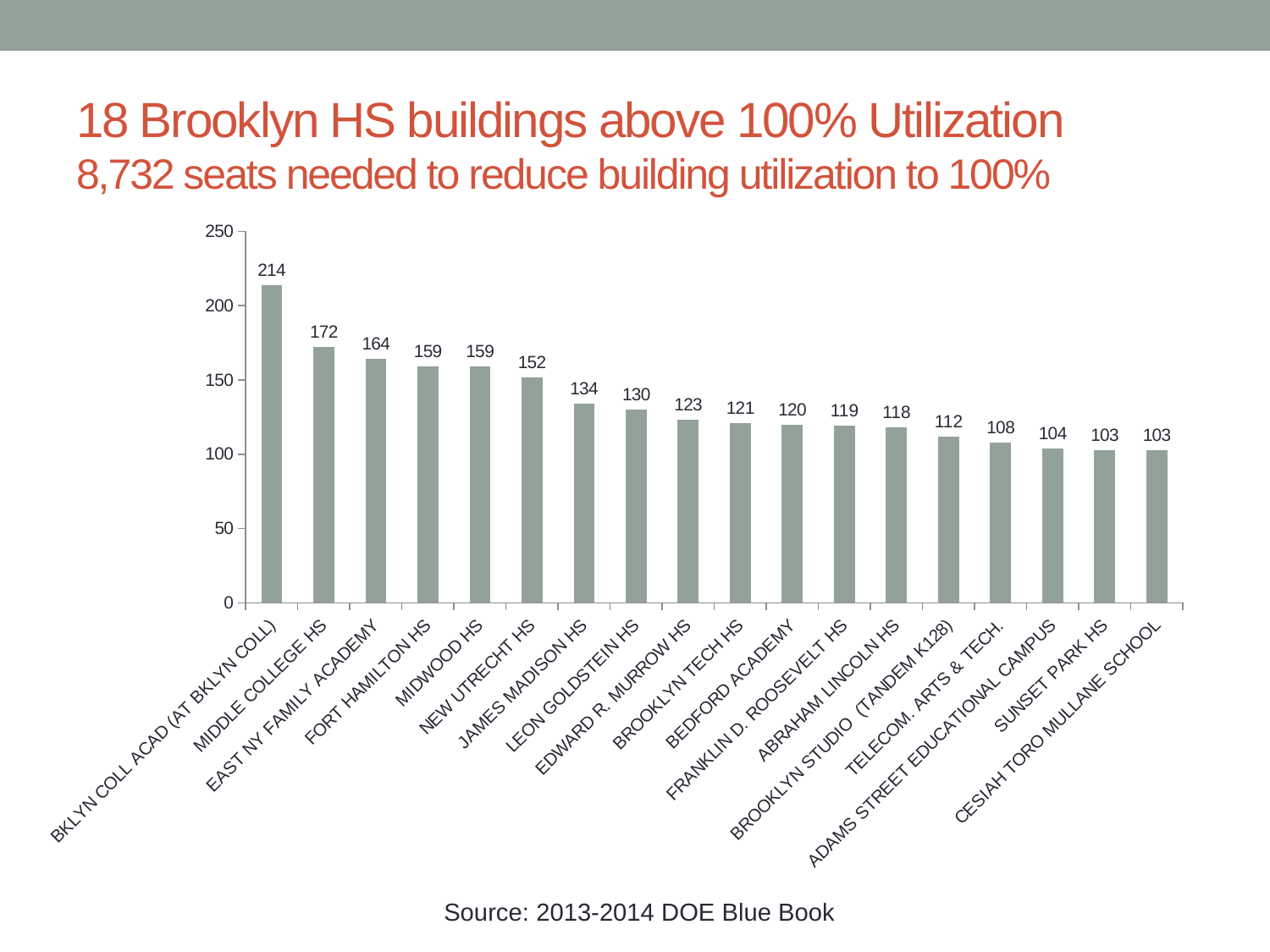
What source is cited below the chart? 2013-2014 DOE Blue Book What is the value for BROOKLYN TECH HS? 121 What is the value for MIDDLE COLLEGE HS? 172 How many buildings are shown in the chart? 18 Which building has the highest value? BKLYN COLL ACAD (AT BKLYN COLL) What kind of chart is shown on the slide? bar chart What is the value for JAMES MADISON HS? 134 Which is larger, the value for LEON GOLDSTEIN HS or the value for BEDFORD ACADEMY? LEON GOLDSTEIN HS What is the difference between the values for EAST NY FAMILY ACADEMY and NEW UTRECHT HS? 12 Do the values rise or fall from left to right along the x axis? fall What is the difference between the values for BKLYN COLL ACAD (AT BKLYN COLL) and MIDDLE COLLEGE HS? 42 Is the value for EDWARD R. MURROW HS greater or less than 150? less